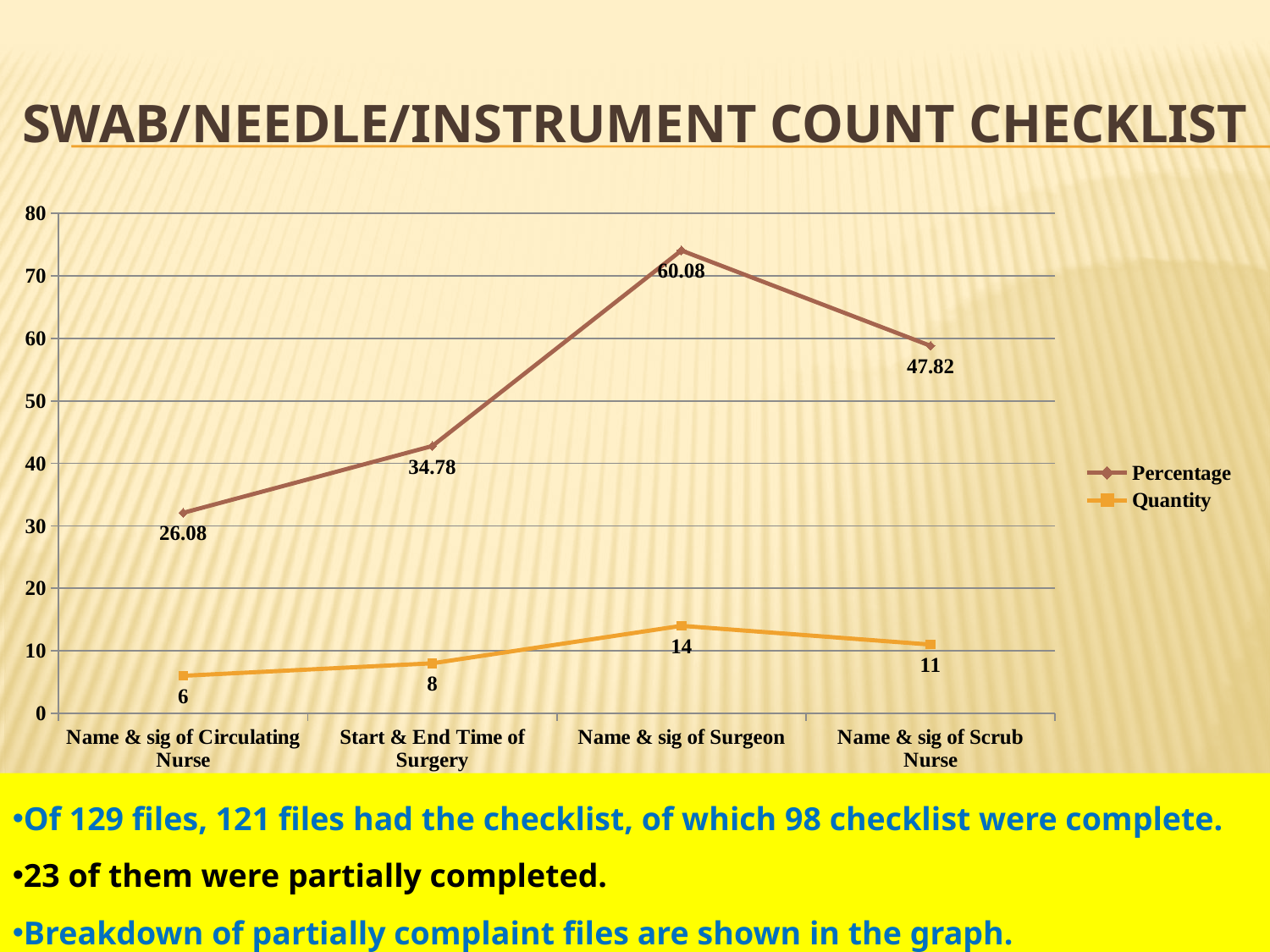
What is the Quantity value for Name & sig of Scrub Nurse? 11 How many series does the legend list? 2 What are the two series names listed in the legend? Percentage and Quantity Which is larger, the Quantity for Name & sig of Scrub Nurse or the Quantity for Start & End Time of Surgery? Name & sig of Scrub Nurse What is the Percentage value for Start & End Time of Surgery? 34.78 What kind of chart is shown on the slide? line chart How many categories are shown on the x axis? 4 Which category has the highest Quantity value? Name & sig of Surgeon What is the difference between the Quantity values for Name & sig of Surgeon and Start & End Time of Surgery? 6 Which category has the lowest Quantity value? Name & sig of Circulating Nurse What is the Percentage value labelled for Name & sig of Circulating Nurse? 26.08 What is the Quantity value for Name & sig of Surgeon? 14